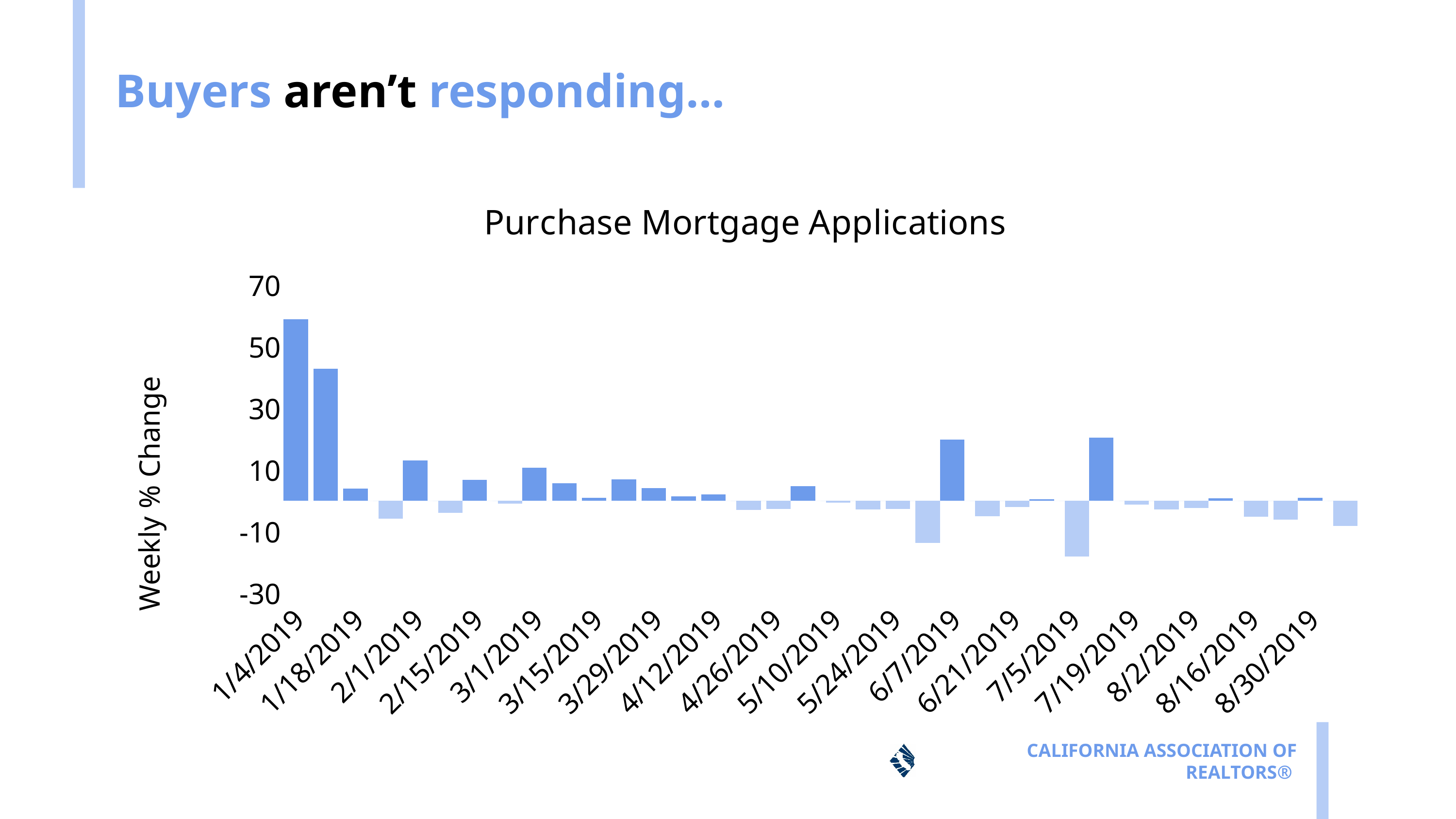
Which date has the lowest weekly % change in the chart? 7/5/2019 What kind of chart is shown on the slide? bar chart What is the label on the vertical axis of the chart? Weekly % Change Which date has the highest weekly % change in the chart? 1/4/2019 Do the weekly % change values generally rise or fall from the start of the chart to the end? fall Is the value for 6/7/2019 greater or less than 10? greater What is the title of the chart? Purchase Mortgage Applications How many date labels are shown along the x axis? 18 Is the value for 7/5/2019 greater or less than -10? less Which is larger, the value for 1/4/2019 or the value for 6/7/2019? 1/4/2019 Is the value for 1/4/2019 greater or less than 50? greater